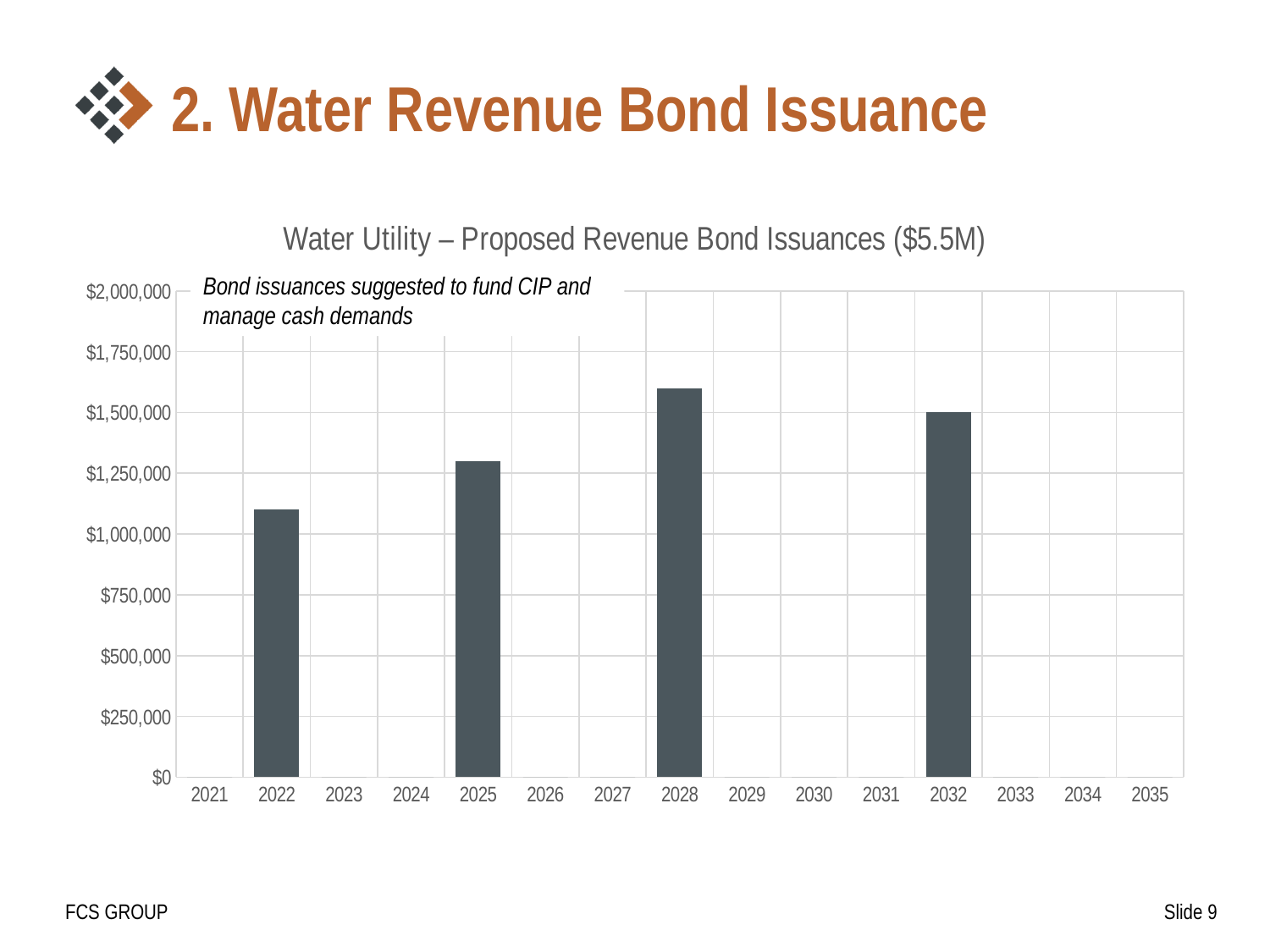
Is the value for 2025 greater or less than $1,500,000? less What is the title of the chart? Water Utility – Proposed Revenue Bond Issuances ($5.5M) What does the italic note on the chart say the bond issuances are suggested to fund? CIP and manage cash demands What is the proposed bond issuance for 2032? $1,500,000 Is the value for 2022 greater or less than $1,000,000? greater Which is larger, the bond issuance for 2025 or for 2032? 2032 How many years are shown on the x axis of the chart? 15 How many years have a bond issuance bar plotted in the chart? 4 Is the value for 2028 greater or less than $1,500,000? greater What kind of chart is shown on the slide? bar chart Among the years with a bar, which year has the lowest proposed bond issuance? 2022 Which year has the highest proposed bond issuance? 2028